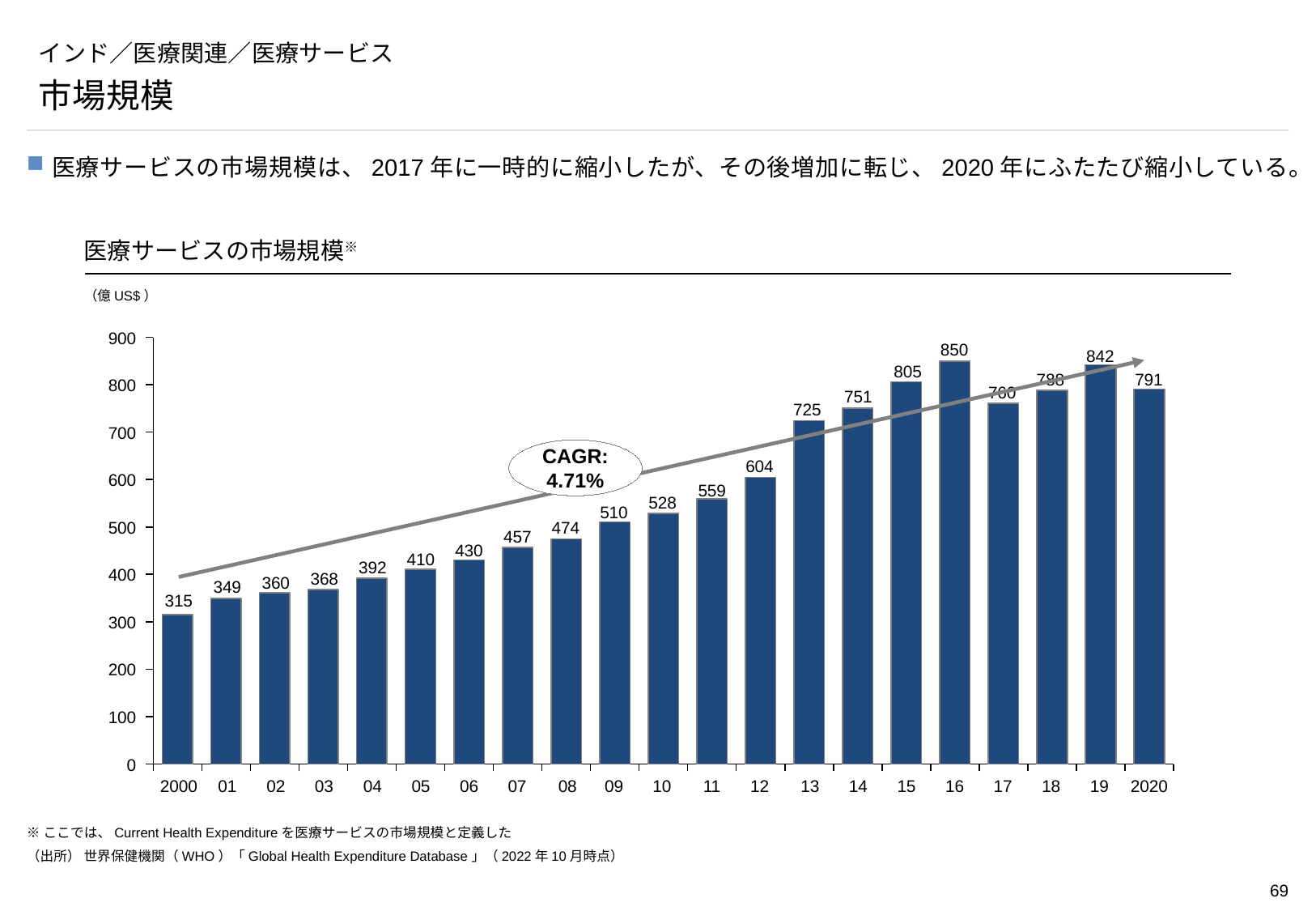
Do the values rise or fall from 2000 to 2016? rise How many years are shown on the x axis? 21 What is the difference between the values for 2019 and 2020? 51 What is the market size value for 2012? 604 Is the value for 2017 greater or less than 700? greater Which is larger, the value for 2012 or the value for 2013? 2013 What CAGR is shown on the chart? 4.71% Which year has the highest market size? 2016 Which year has the lowest market size? 2000 What is the market size value for 2016? 850 What kind of chart is shown on the slide? bar chart What is the market size value for 2000? 315